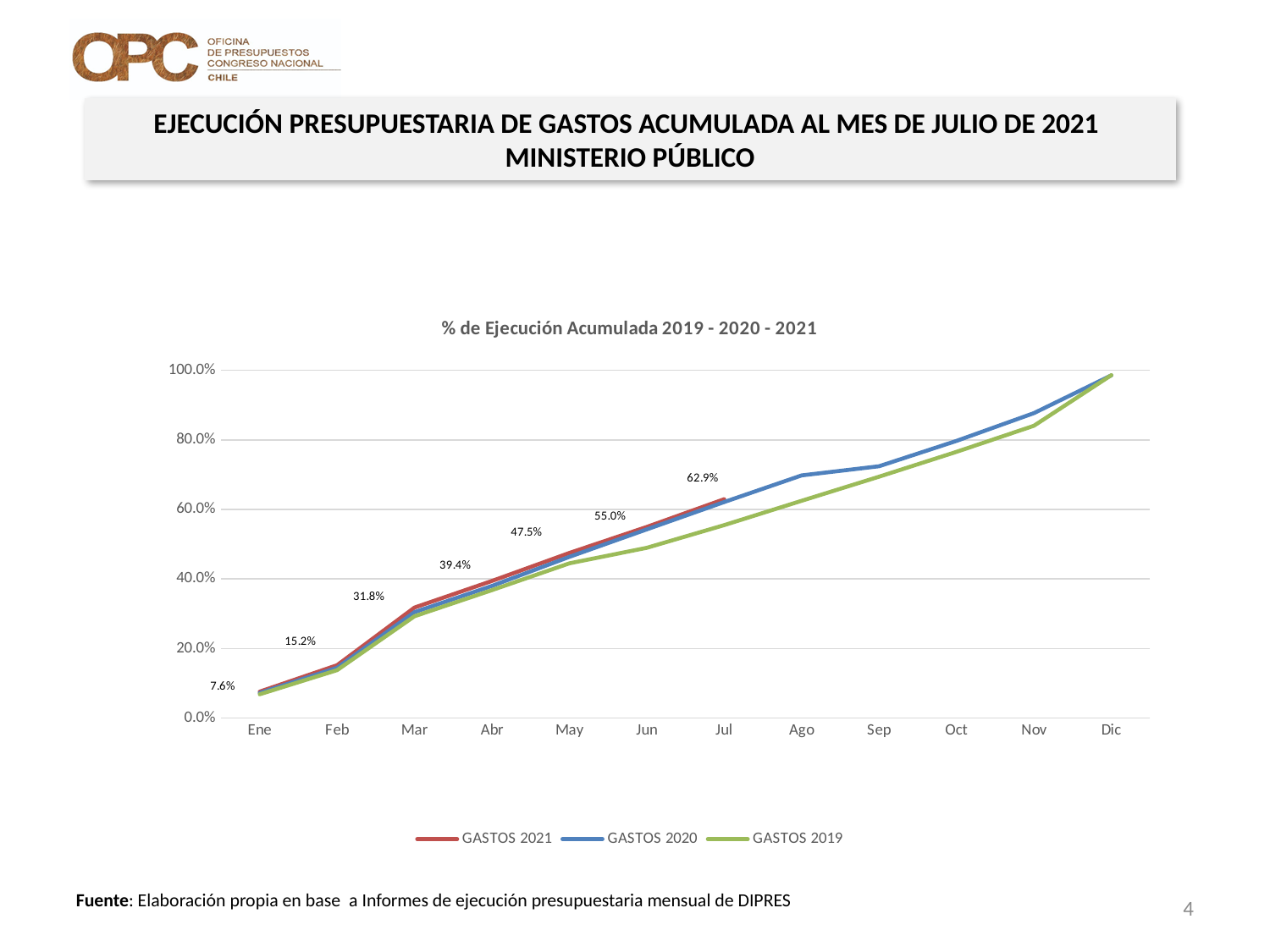
How many months are shown on the x axis? 12 What kind of chart is shown on the slide? Line chart Which month has the highest labelled value for GASTOS 2021? Jul Which is larger for GASTOS 2021: the value in Abr or the value in Jun? Jun What is the difference between the GASTOS 2021 values for Feb and Ene? 7.6 percentage points What is the value of GASTOS 2021 in Ene? 7.6% What is the value of GASTOS 2021 in Jul? 62.9% What is the value of GASTOS 2021 in May? 47.5% Is the value for GASTOS 2019 in Nov greater or less than 80.0%? greater How many series does the legend list? 3 What is the value of GASTOS 2021 in Mar? 31.8% By how many percentage points did GASTOS 2021 increase from Jun to Jul? 7.9 percentage points